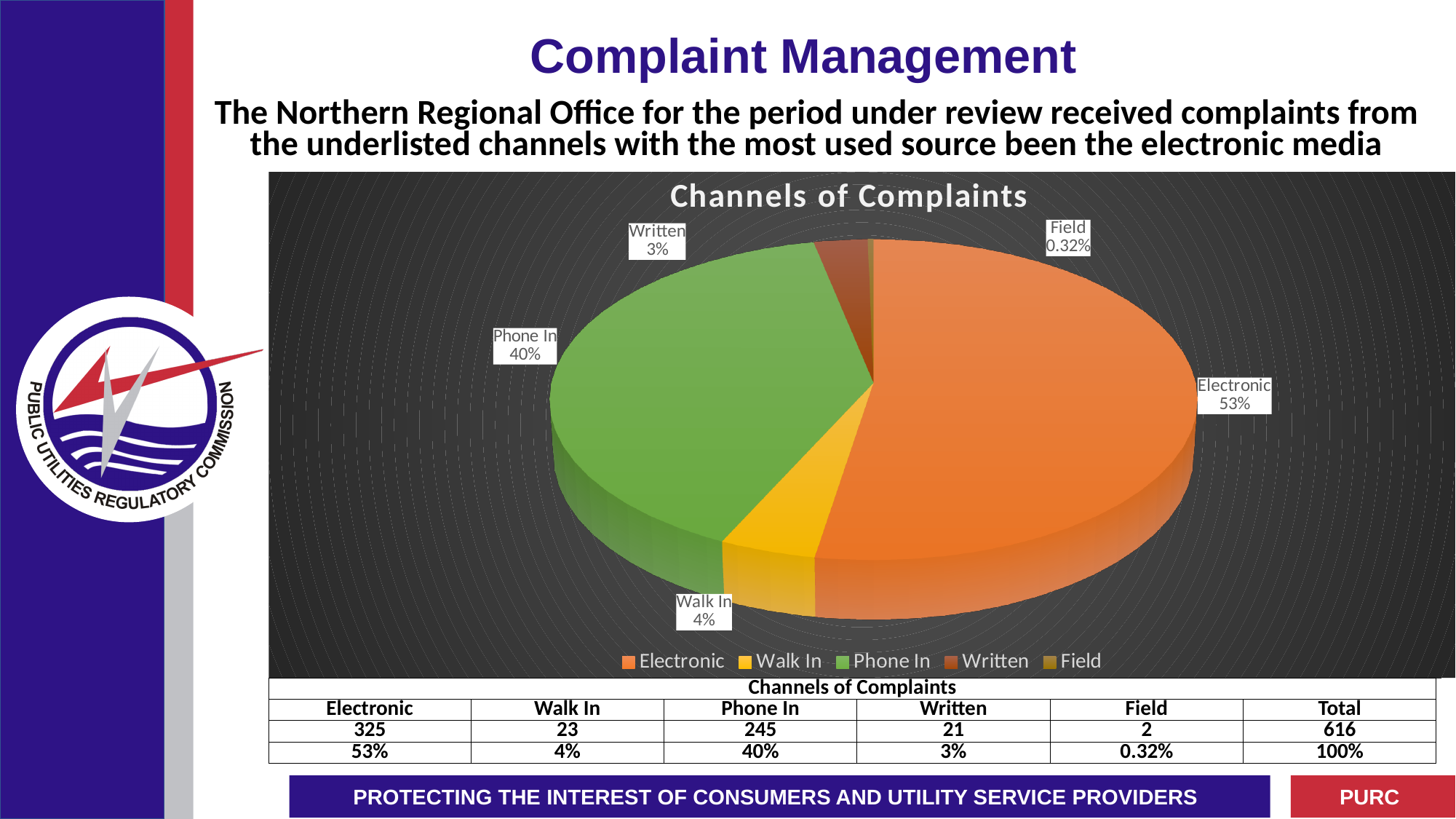
What percentage share does the Phone In slice have? 40% What is the title of the chart? Channels of Complaints How many channels (slices) are shown in the pie chart? 5 Which channel has the largest share of complaints? Electronic Which channel has the smallest share of complaints? Field What is the difference in percentage points between the Electronic share and the Phone In share? 13% Which is larger, the Walk In share or the Written share? Walk In How many entries does the legend list? 5 What type of chart is shown on the slide? Pie chart What colour is the Phone In slice? Green What percentage share does the Electronic slice have? 53% What percentage share does the Field slice have? 0.32%